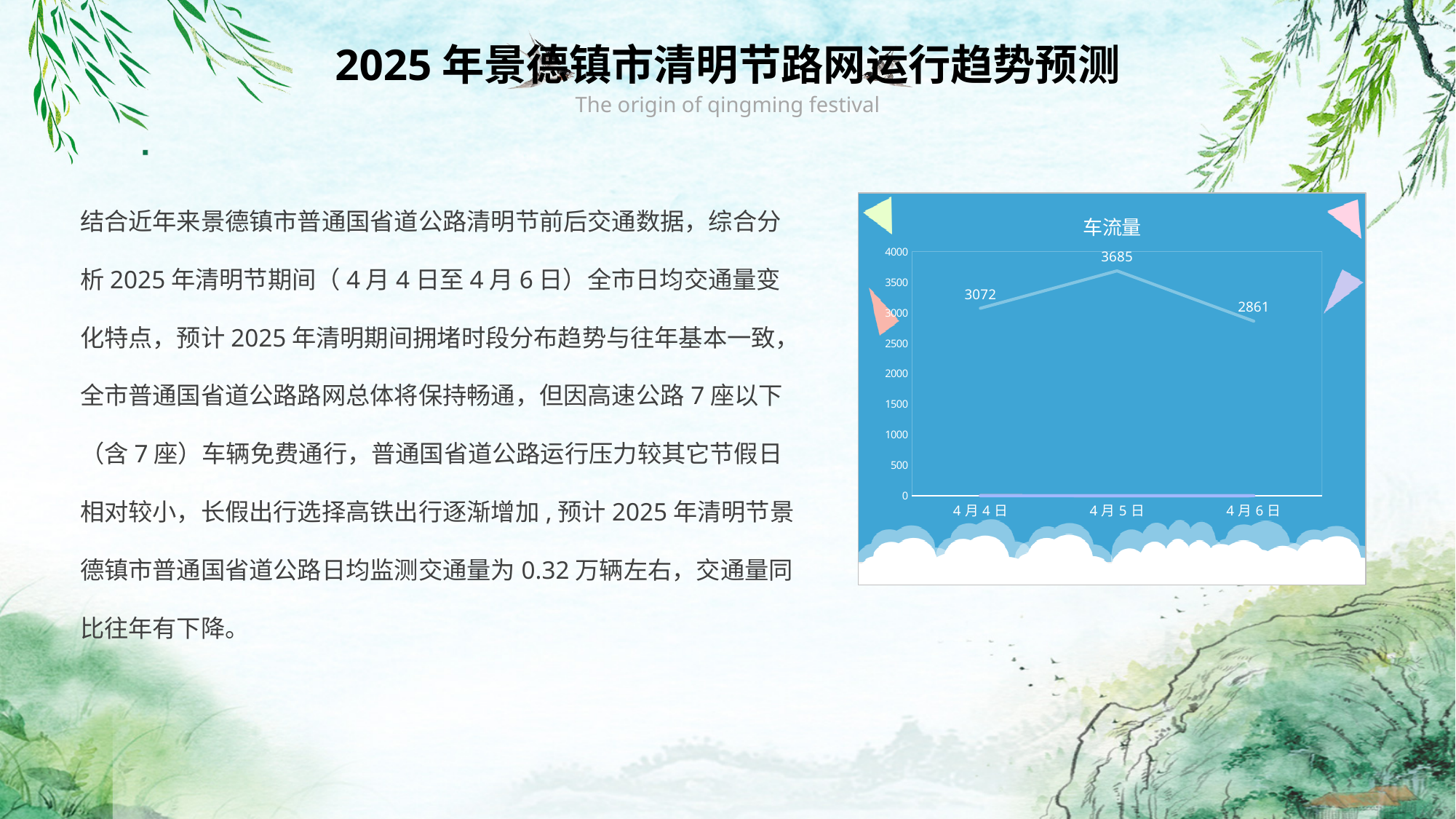
Which date has the lowest 车流量 value? 4月6日 What is the 车流量 value for 4月6日? 2861 How many dates are plotted on the x axis of the chart? 3 What is the title of the chart? 车流量 What type of chart is shown on the slide? line chart Which is larger, the 车流量 value for 4月4日 or for 4月6日? 4月4日 Does the 车流量 line rise or fall from 4月5日 to 4月6日? fall Which date has the highest 车流量 value? 4月5日 What is the difference between the 车流量 values for 4月4日 and 4月6日? 211 What is the 车流量 value for 4月4日? 3072 What is the 车流量 value for 4月5日? 3685 What is the difference between the 车流量 values for 4月5日 and 4月4日? 613